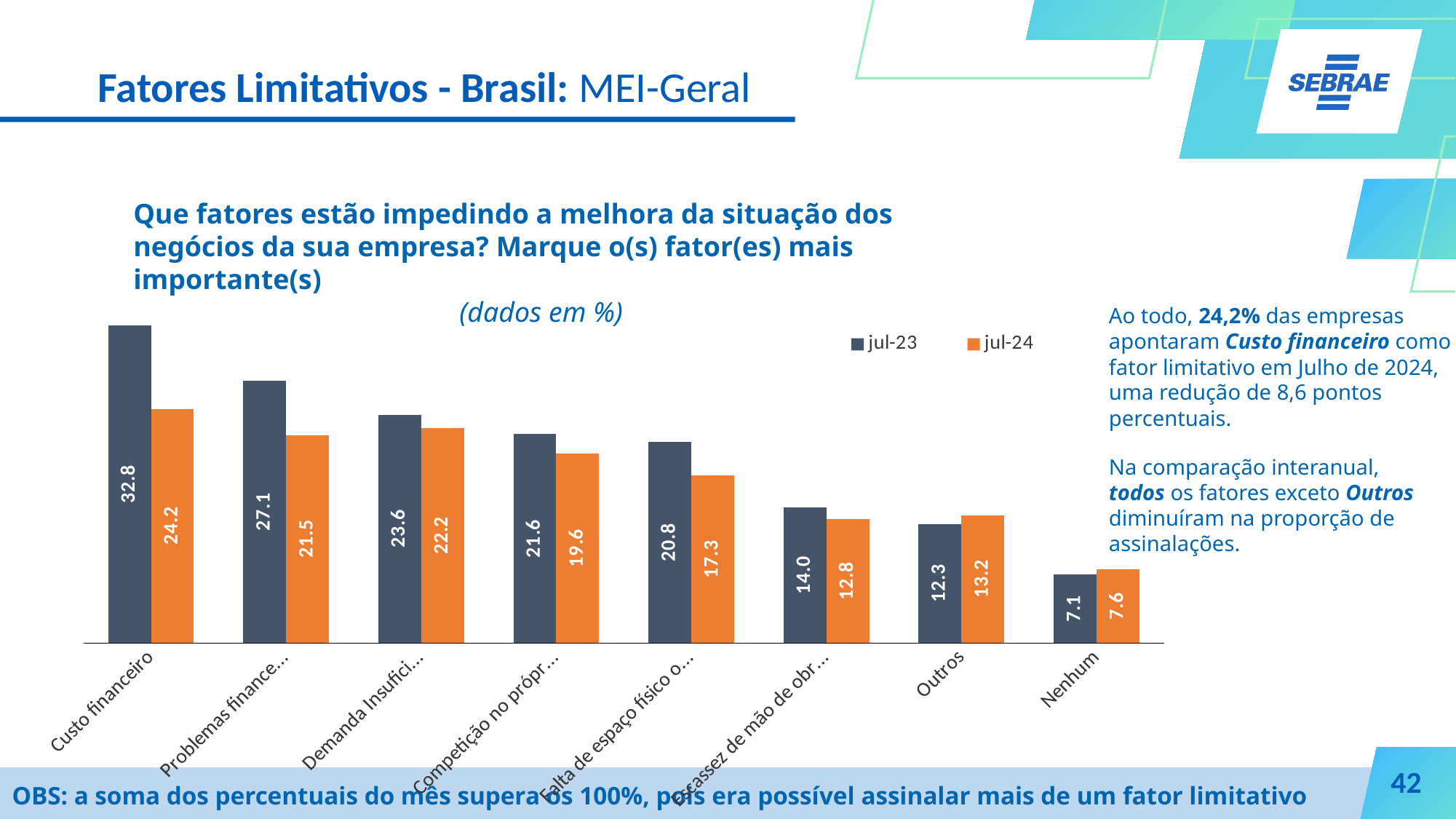
How many series does the legend list? 2 What is the jul-24 value for Outros? 13.2 What kind of chart is shown on the slide? bar chart For Outros, which series has the larger value, jul-23 or jul-24? jul-24 What is the jul-23 value for Nenhum? 7.1 How many categories are shown on the x axis of the chart? 8 Which category has the lowest jul-24 value? Nenhum Which category has the highest jul-23 value? Custo financeiro What is the jul-23 value for Custo financeiro? 32.8 What is the jul-24 value for Custo financeiro? 24.2 Do the jul-23 values rise or fall from left to right along the x axis? fall What is the difference between the jul-23 and jul-24 values for Custo financeiro? 8.6